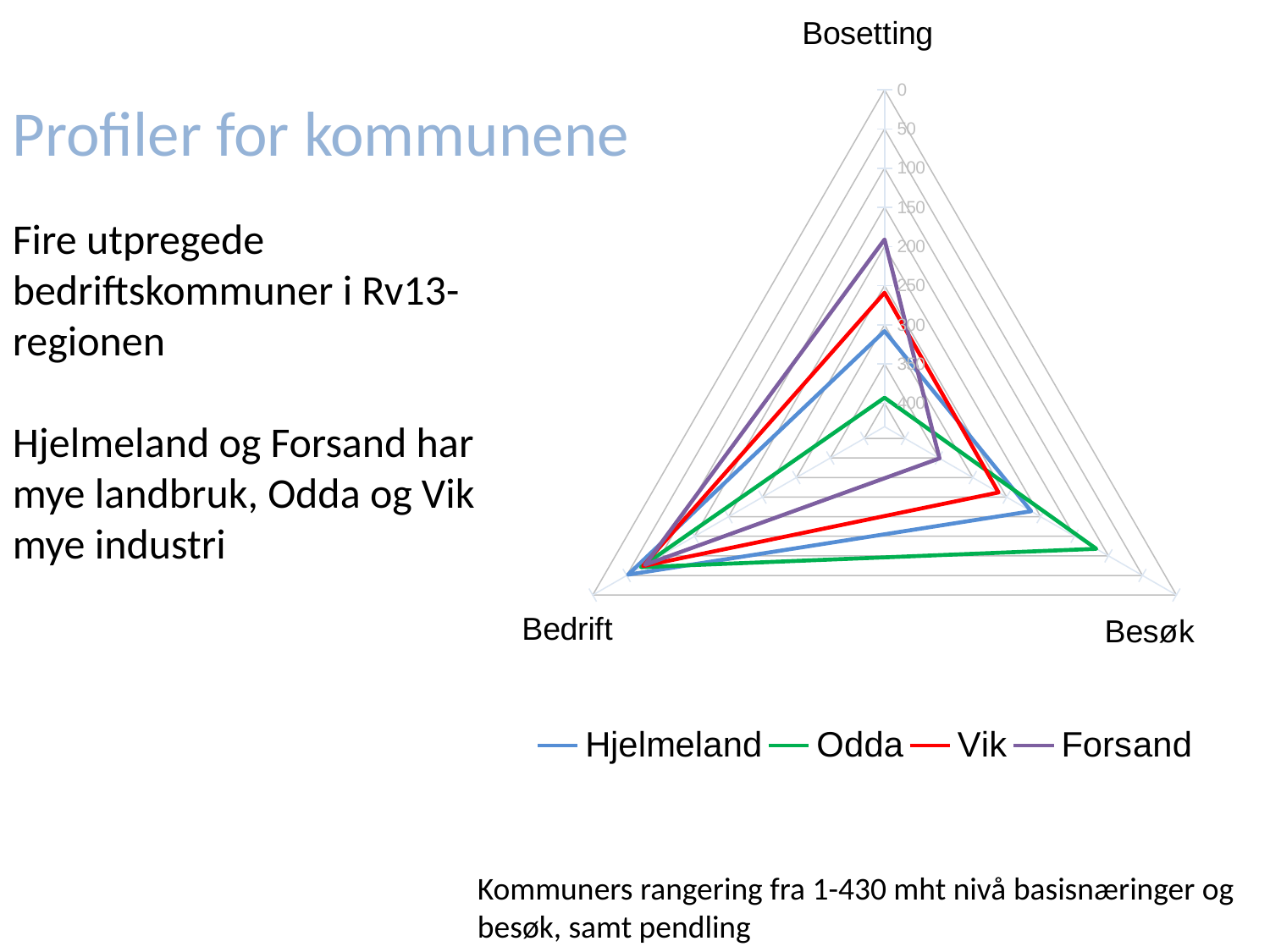
What kind of chart is shown on the slide? Radar chart How many axes (categories) does the radar chart have? 3 Is the Bosetting value for Odda greater or less than 300? greater Is the Besøk value for Odda greater or less than 200? less Which series has the highest value on the Bosetting axis? Odda Which series has the lowest value on the Bosetting axis? Forsand Which series has the highest value on the Besøk axis? Forsand On the Bosetting axis, which has the larger value, Odda or Vik? Odda Is the Bedrift value for Hjelmeland greater or less than 100? less How many series does the legend list? 4 What colour is the line for Vik in the chart? Red Which series has the lowest value on the Besøk axis? Odda